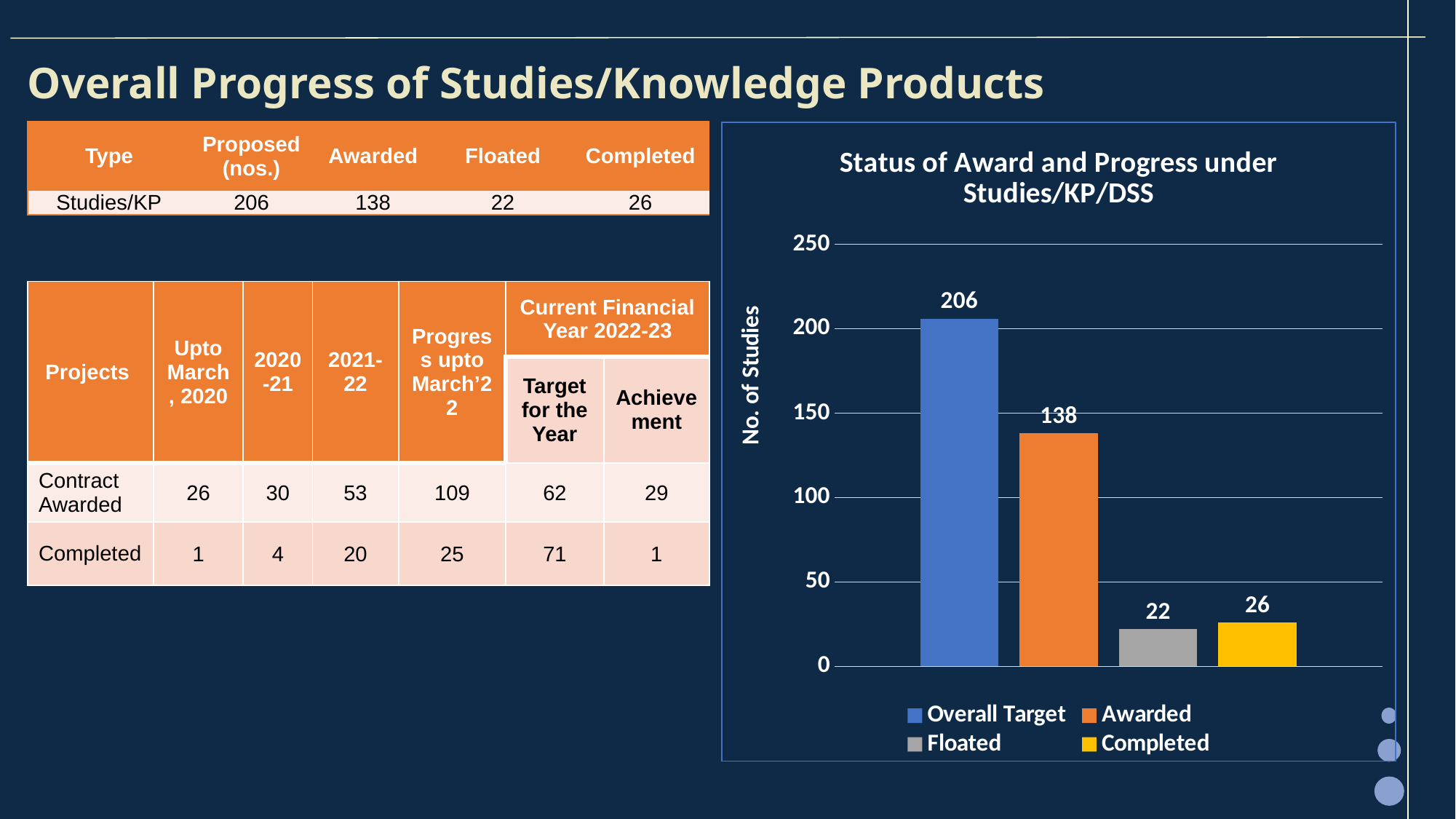
Is the value for Awarded greater or less than 150? less What is the title of the chart? Status of Award and Progress under Studies/KP/DSS What is the value for Awarded in the chart? 138 What is the value for Completed in the chart? 26 What is the value for Floated in the chart? 22 What is the value for Overall Target in the chart? 206 Which series has the highest value in the chart? Overall Target Which is larger in the chart, Completed or Floated? Completed Which series has the lowest value in the chart? Floated How many series does the chart legend list? 4 What is the difference between Overall Target and Awarded in the chart? 68 What kind of chart is shown on the slide? Bar chart